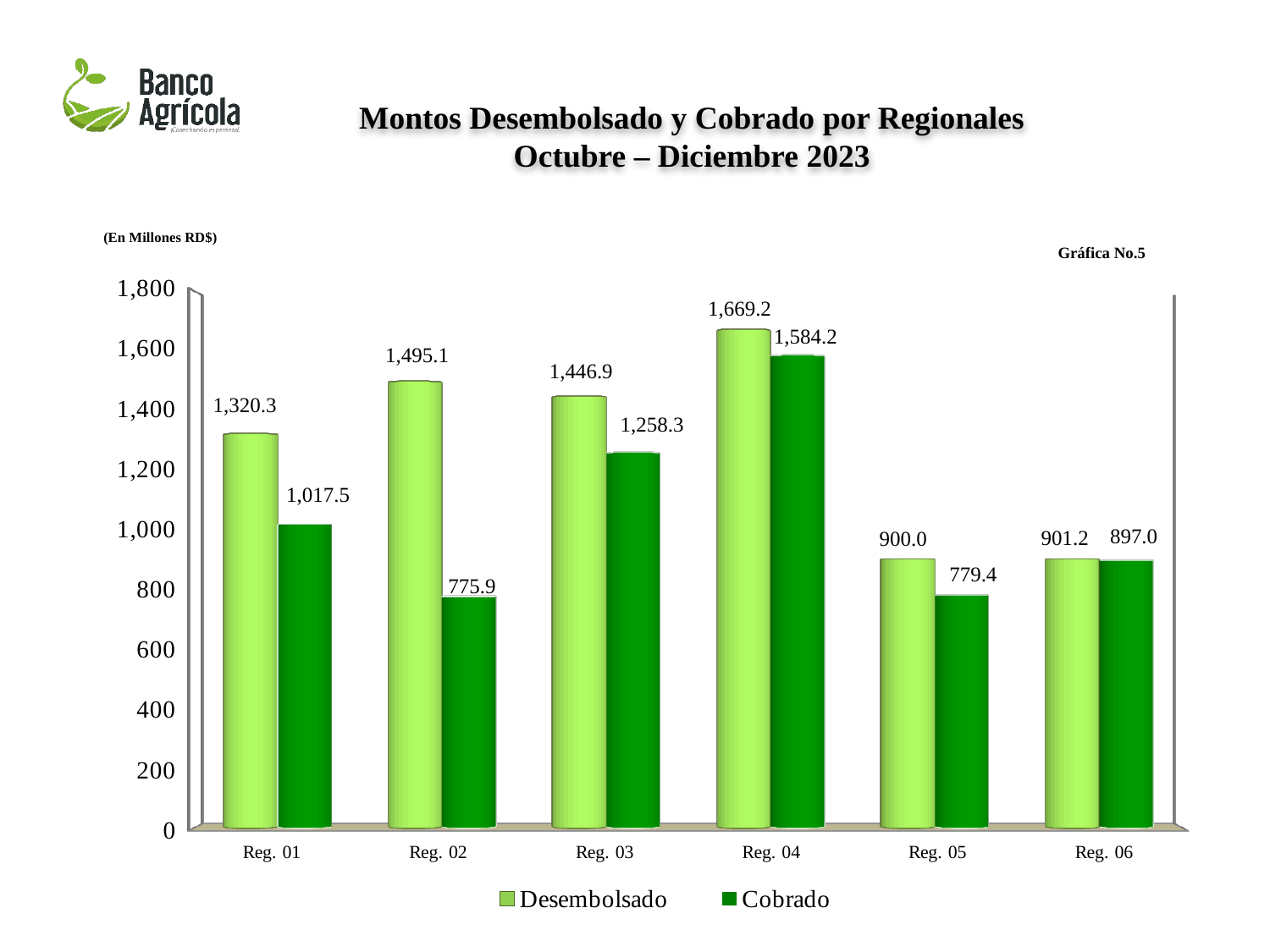
Which region has the highest Cobrado value? Reg. 04 What kind of chart is shown on the slide? Bar chart What is the Desembolsado value for Reg. 01? 1,320.3 Which region has the highest Desembolsado value? Reg. 04 What is the Cobrado value for Reg. 02? 775.9 Which is larger for Reg. 03, Desembolsado or Cobrado? Desembolsado How many regions are shown on the x axis? 6 What is the difference between Desembolsado and Cobrado for Reg. 02? 719.2 What is the Desembolsado value for Reg. 06? 901.2 What is the difference between Desembolsado and Cobrado for Reg. 04? 85.0 What is the Cobrado value for Reg. 03? 1,258.3 How many series does the legend list? 2